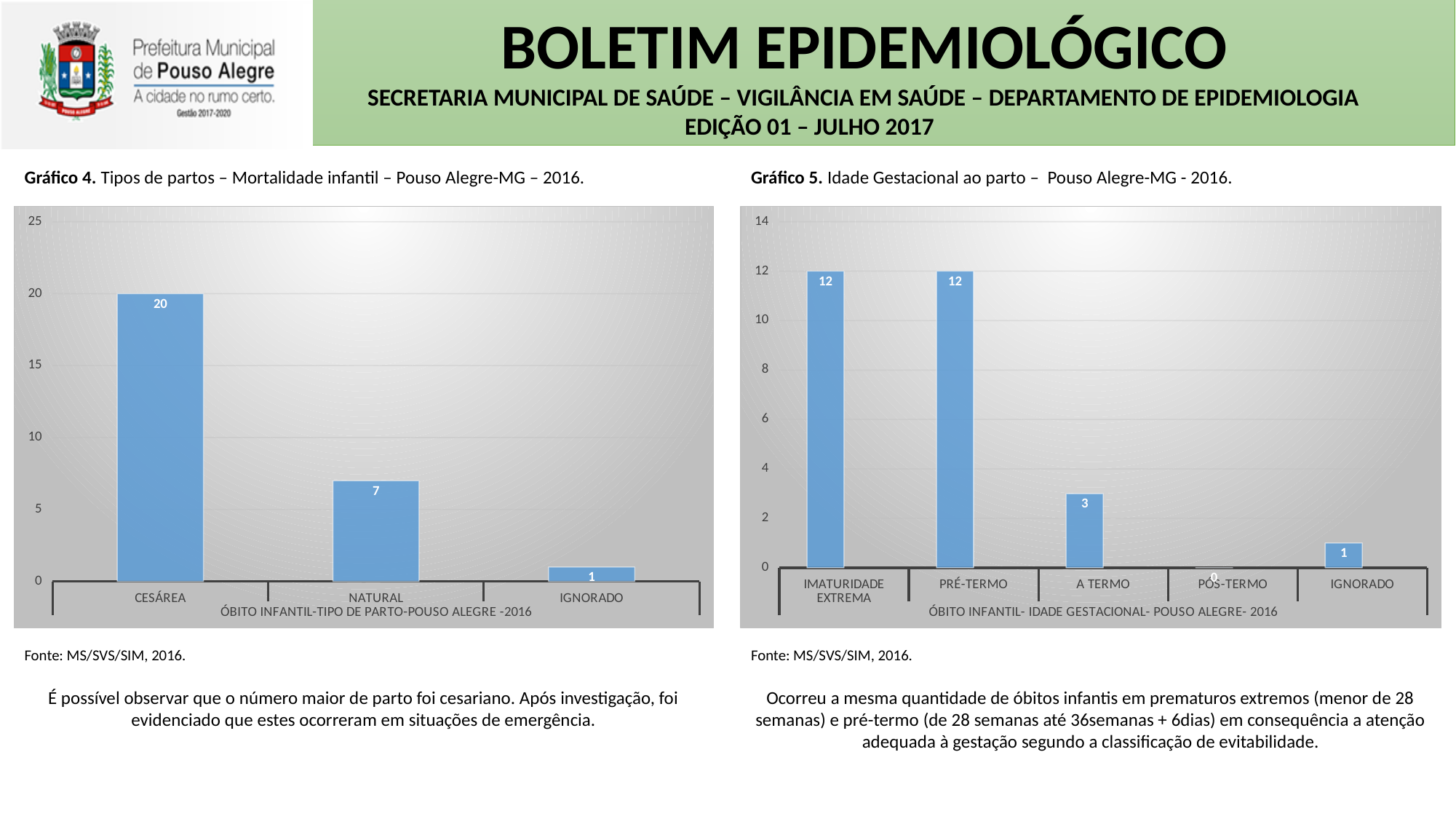
In Gráfico 5 (right chart), which is larger, the value for A TERMO or the value for IGNORADO? A TERMO In Gráfico 5 (right chart), which category has the lowest value? PÓS-TERMO In Gráfico 4 (left chart), what is the value for NATURAL? 7 In Gráfico 4 (left chart), what is the difference between the values for CESÁREA and NATURAL? 13 In Gráfico 5 (right chart), what is the total of the values for IMATURIDADE EXTREMA and PRÉ-TERMO? 24 In Gráfico 4 (left chart), which category has the lowest value? IGNORADO In Gráfico 4 (left chart), what kind of chart is shown? bar chart In Gráfico 5 (right chart), how many categories are shown on the x axis? 5 In Gráfico 5 (right chart), what is the value for A TERMO? 3 In Gráfico 5 (right chart), what is the value for IGNORADO? 1 In Gráfico 4 (left chart), how many categories are shown on the x axis? 3 In Gráfico 4 (left chart), what is the value for CESÁREA? 20